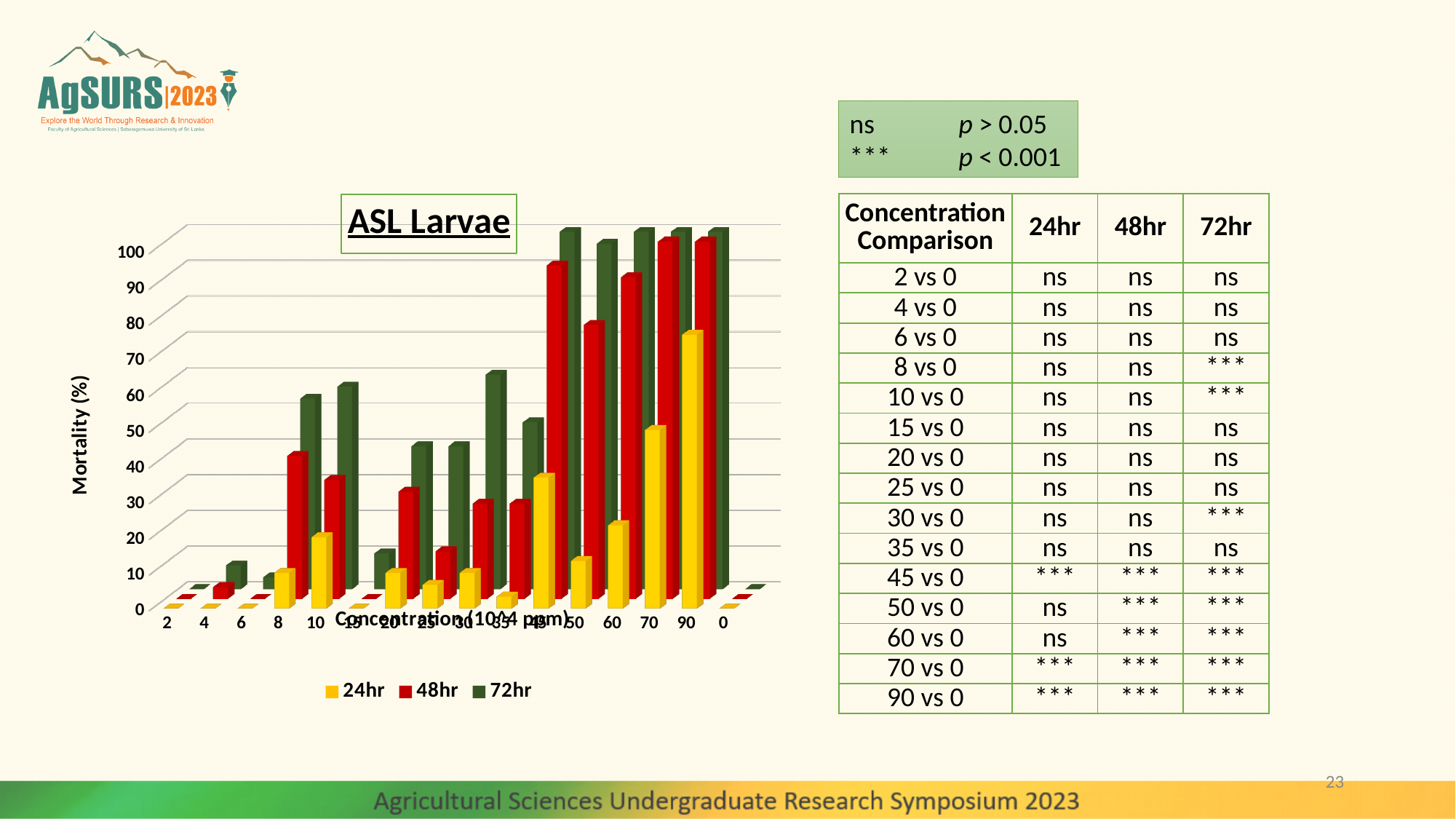
What kind of chart is shown on the slide? bar chart How many concentration categories are shown on the x axis of the chart? 16 What is the label of the y axis of the chart? Mortality (%) Is the 24hr mortality value at concentration 90 greater or less than 60? greater How many series does the chart legend list? 3 Do the 24hr mortality values rise or fall across concentrations 50, 60, 70 and 90? rise Is the 72hr mortality value at concentration 10 greater or less than 40? greater Is the 48hr mortality value at concentration 45 greater or less than 80? greater At concentration 8, which series has the larger mortality value, 24hr or 48hr? 48hr What is the title of the chart? ASL Larvae At concentration 10, which series has the larger mortality value, 24hr or 72hr? 72hr